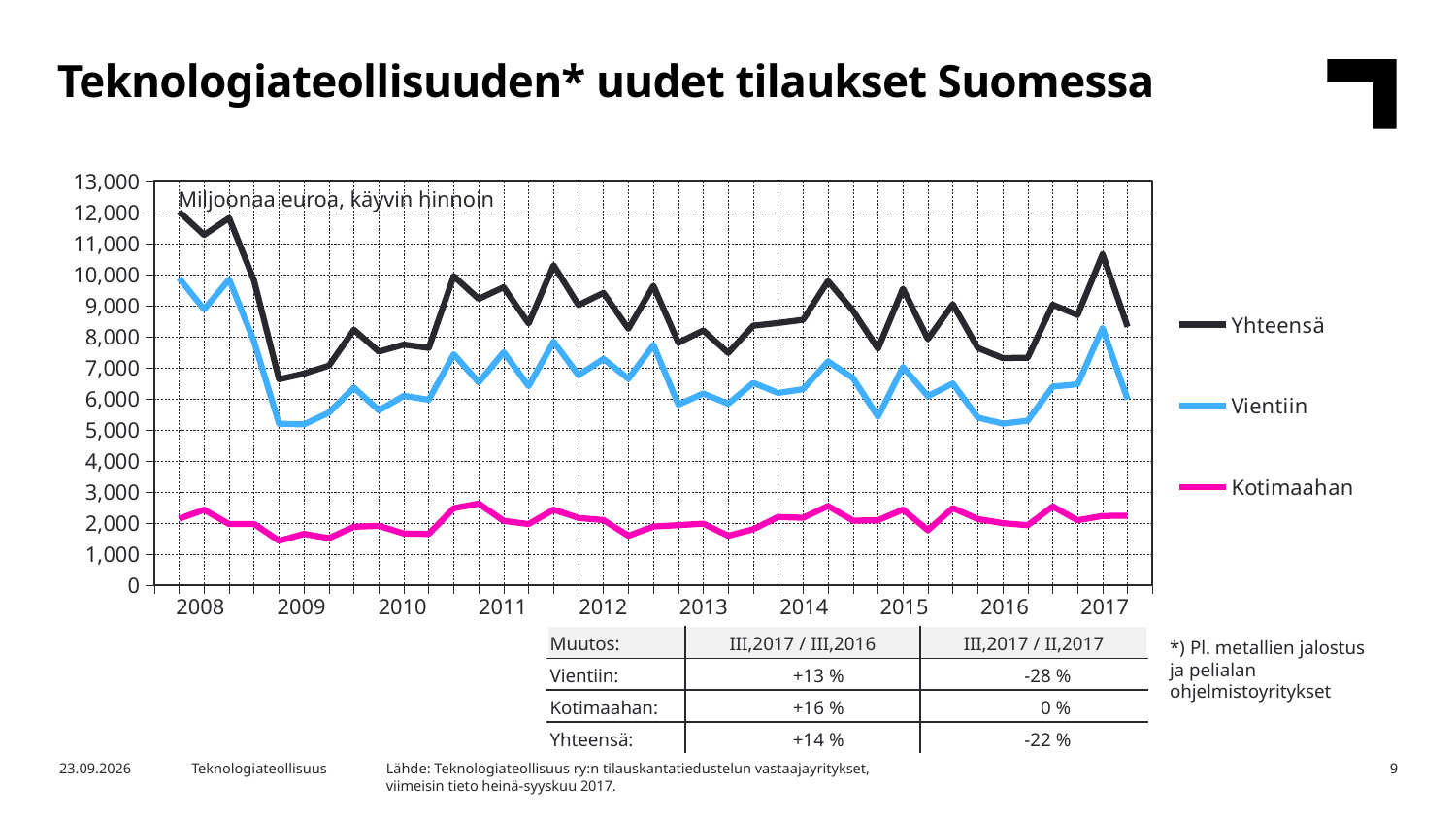
Is the value for Kotimaahan at the start of 2008 greater or less than 3,000? less Is the value for Yhteensä at the start of 2008 greater or less than 10,000? greater Which series has the highest values throughout the chart? Yhteensä Which series has the lowest values throughout the chart? Kotimaahan Does the Yhteensä series rise or fall from the start of 2008 to the start of 2009? fall Which is larger in 2012, the value for Vientiin or the value for Kotimaahan? Vientiin Is the lowest value for Vientiin in 2009 greater or less than 6,000? less How many years are labelled on the x axis? 10 How many series does the chart legend list? 3 What unit is stated in the label inside the chart area? Miljoonaa euroa, käyvin hinnoin What kind of chart is shown on the slide? line chart Which series are listed in the chart legend? Yhteensä, Vientiin, Kotimaahan